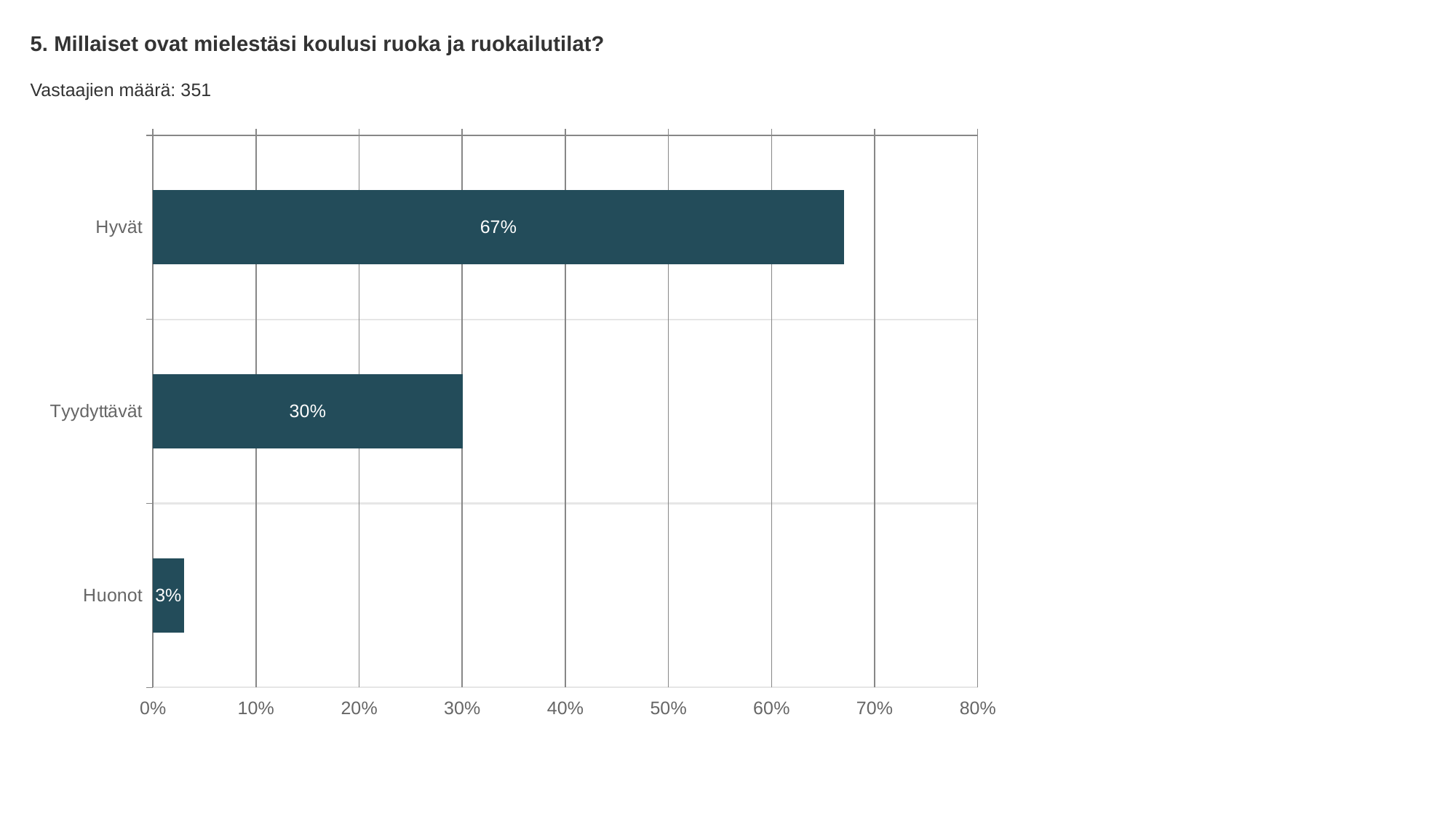
What is the difference between the values for Tyydyttävät and Huonot? 27% Is the value for Hyvät greater or less than 60%? greater Which category has the highest value? Hyvät What is the value for Tyydyttävät? 30% How many respondents (Vastaajien määrä) does the slide report? 351 How many categories are shown in the chart? 3 Which is larger, the value for Tyydyttävät or the value for Huonot? Tyydyttävät What is the value for Hyvät? 67% What is the difference between the values for Hyvät and Tyydyttävät? 37% Which category has the lowest value? Huonot What is the value for Huonot? 3% What kind of chart is shown on the slide? bar chart